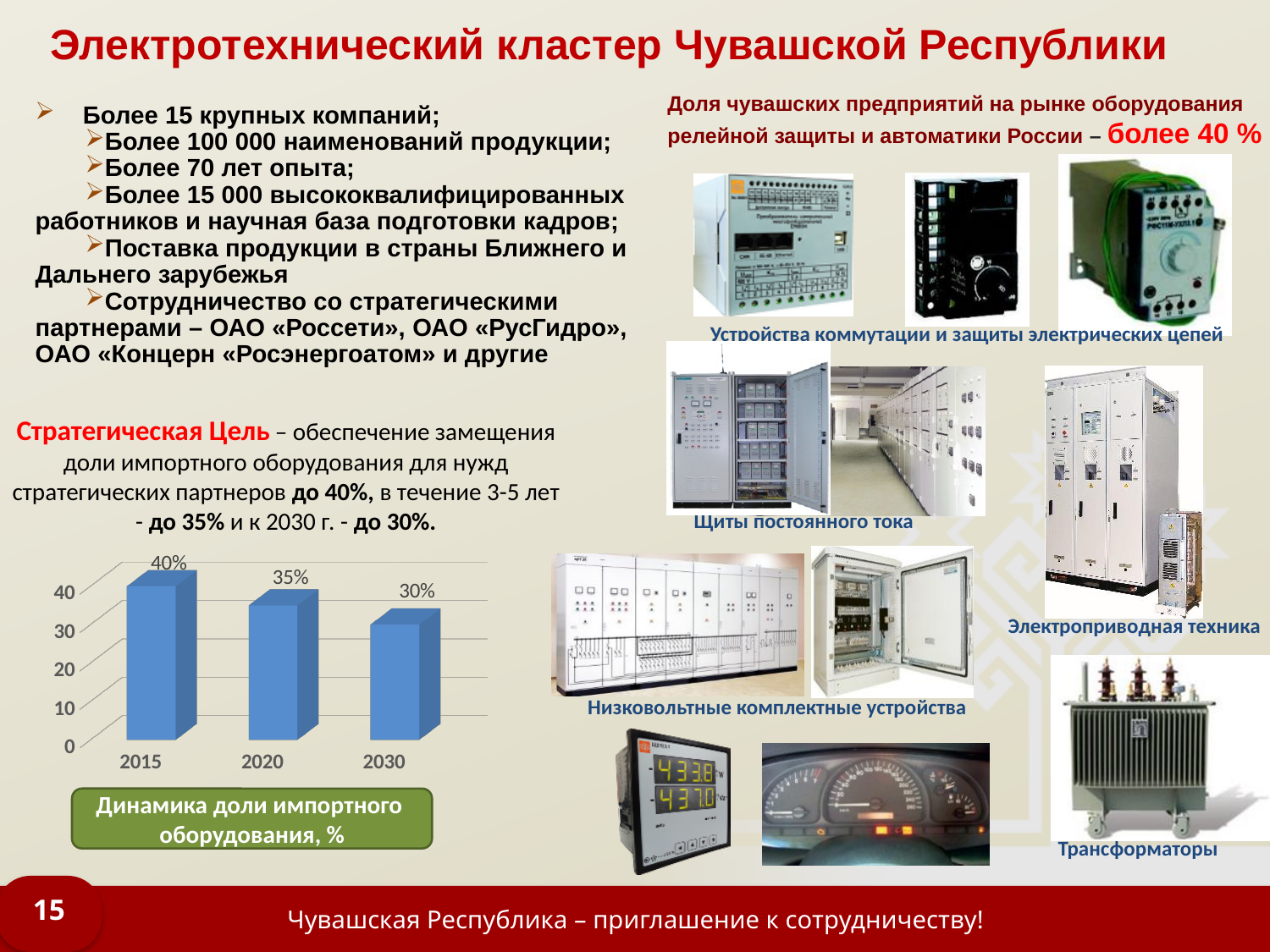
Which is larger, the value for 2015 or the value for 2020? 2015 What is the value for 2015 in the chart? 40% What is the difference between the values for 2015 and 2030? 10% What kind of chart is shown on the slide? bar chart What is the value for 2020 in the chart? 35% Which year has the lowest value in the chart? 2030 How many categories are shown on the x axis of the chart? 3 Which year has the highest value in the chart? 2015 What is the difference between the values for 2020 and 2030? 5% Do the values rise or fall from 2015 to 2030 in the chart? fall What is the value for 2030 in the chart? 30% What is the title shown below the chart? Динамика доли импортного оборудования, %